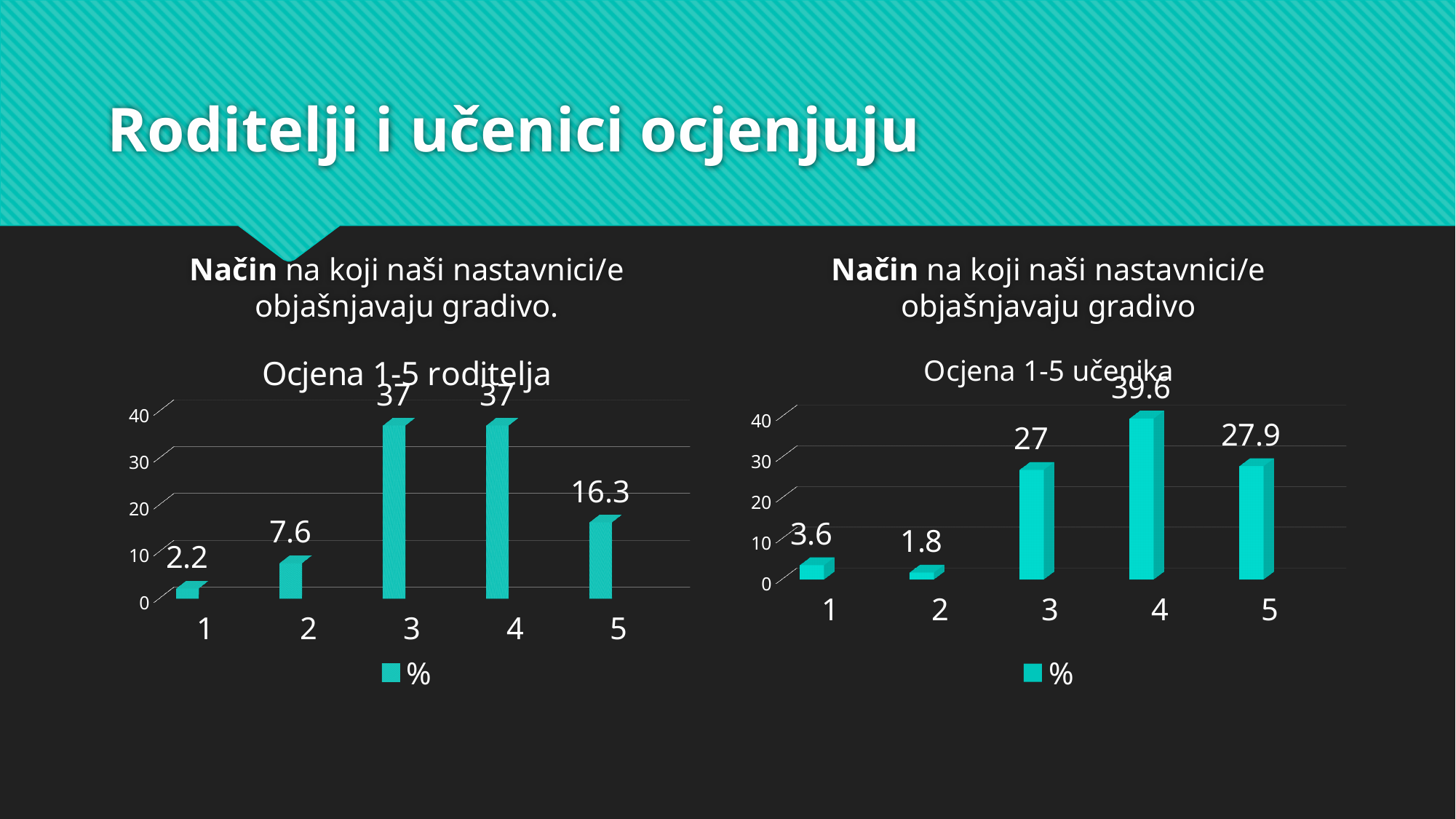
How many series does the legend of the chart titled "Ocjena 1-5 roditelja" list? 1 What kind of chart is the chart titled "Ocjena 1-5 roditelja"? bar chart In the chart titled "Ocjena 1-5 učenika", what is the difference between the values for category 4 and category 3? 12.6 In the chart titled "Ocjena 1-5 roditelja", what is the difference between the values for category 4 and category 5? 20.7 In the chart titled "Ocjena 1-5 roditelja", what is the value for category 5? 16.3 In the chart titled "Ocjena 1-5 roditelja", which category has the lowest value? 1 In the chart titled "Ocjena 1-5 učenika", which category has the lowest value? 2 In the chart titled "Ocjena 1-5 roditelja", is the value for category 2 greater or less than 10? less In the chart titled "Ocjena 1-5 učenika", what is the value for category 3? 27 In the chart titled "Ocjena 1-5 učenika", which category has the highest value? 4 In the chart titled "Ocjena 1-5 učenika", which is larger: the value for category 5 or the value for category 3? 5 How many categories are shown in the chart titled "Ocjena 1-5 učenika"? 5